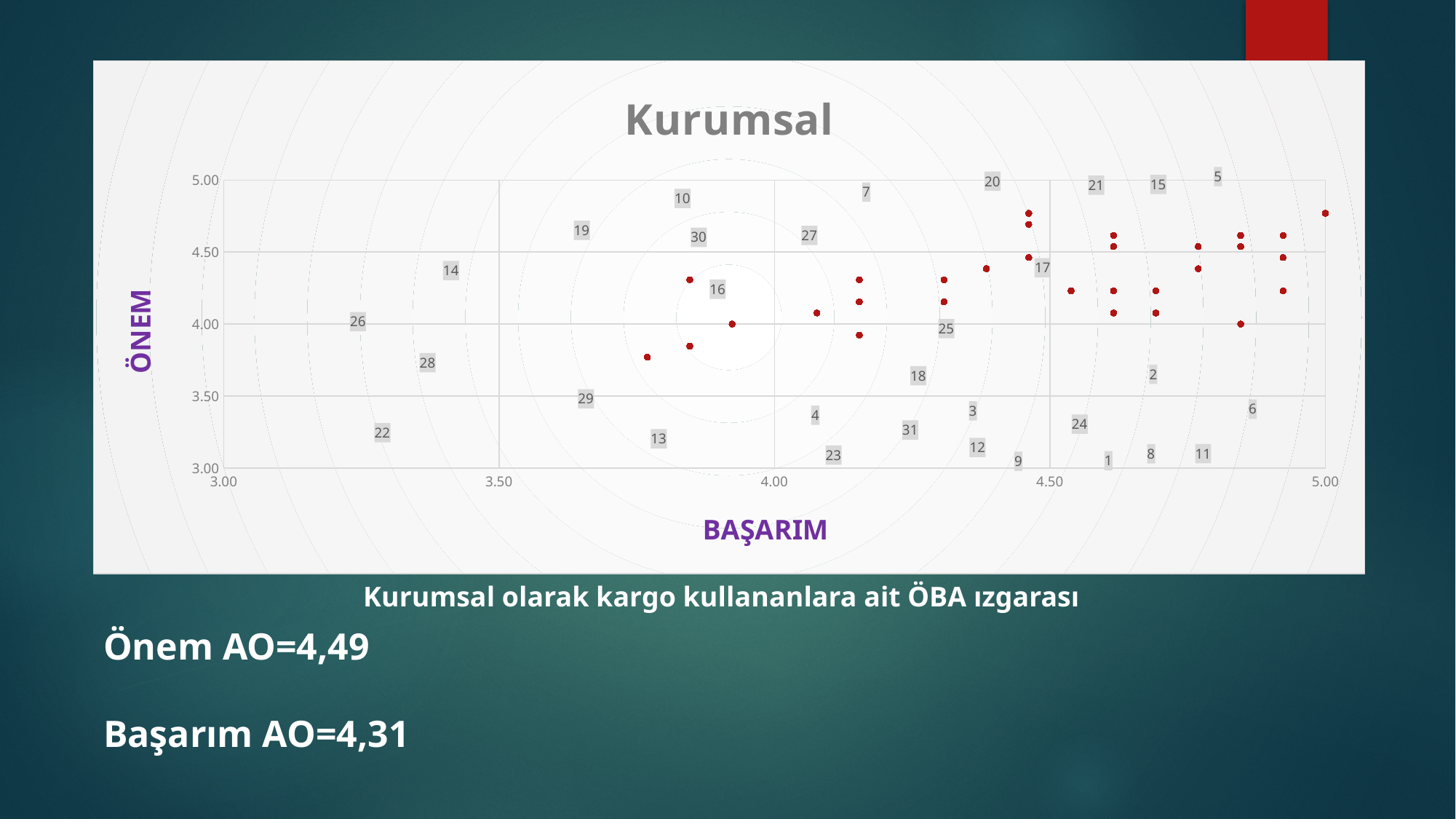
Are there any points in the chart with a BAŞARIM value below 3.50? No Is the ÖNEM value of the lowest point in the chart greater or less than 4.00? less What label is on the horizontal axis of the chart? BAŞARIM Is the BAŞARIM value of the leftmost point in the chart greater or less than 4.00? less What kind of chart is shown on the slide? scatter chart What is the title of the chart? Kurumsal